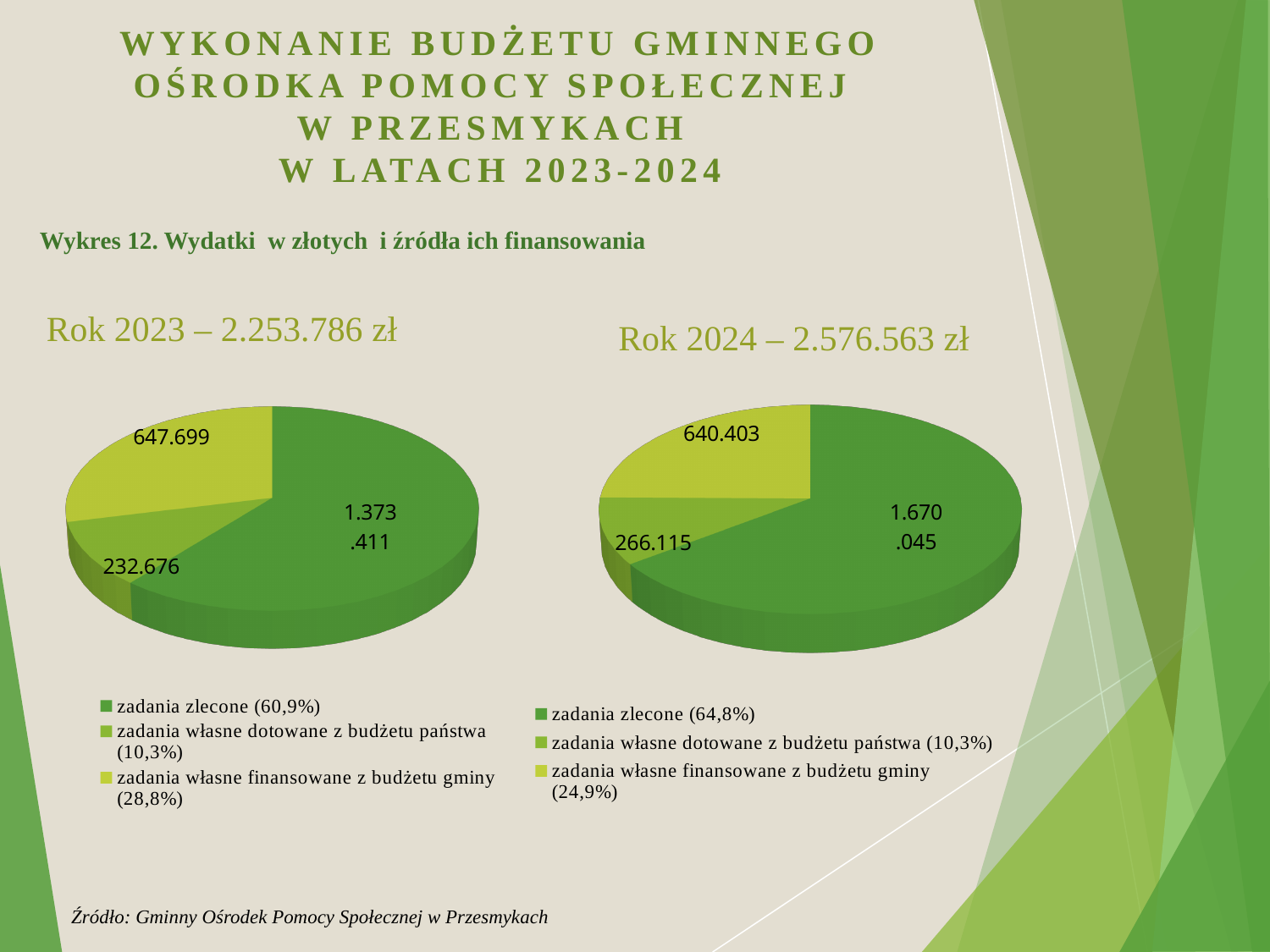
In the Rok 2023 chart, which category has the largest slice? zadania zlecone In the Rok 2023 chart, what is the value for zadania zlecone? 1.373.411 In the Rok 2023 chart, what share of the pie is zadania własne finansowane z budżetu gminy? 28,8% In the Rok 2024 chart, which category has the smallest slice? zadania własne dotowane z budżetu państwa Which is larger: zadania własne finansowane z budżetu gminy in the Rok 2023 chart or in the Rok 2024 chart? Rok 2023 In the Rok 2024 chart, what is the value for zadania zlecone? 1.670.045 In the Rok 2024 chart, what share of the pie is zadania zlecone? 64,8% In the Rok 2023 chart, what is the value for zadania własne dotowane z budżetu państwa? 232.676 How many categories does the Rok 2024 chart's legend list? 3 In the Rok 2024 chart, what is the value for zadania własne finansowane z budżetu gminy? 640.403 In the Rok 2023 chart, what is the difference between zadania zlecone and zadania własne finansowane z budżetu gminy? 725.712 What kind of chart is used for Rok 2023? pie chart